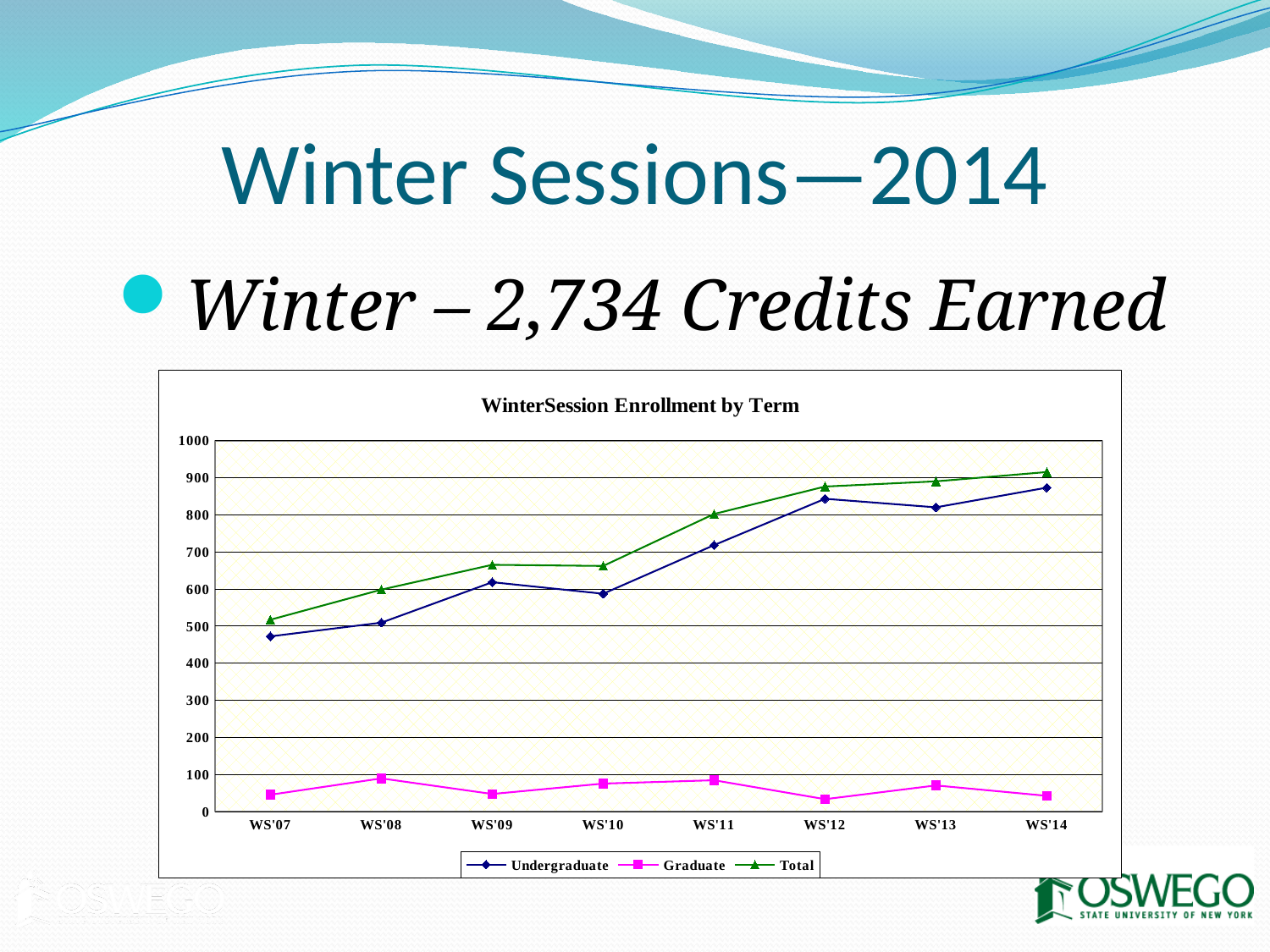
Which is larger, the Undergraduate value for WS'09 or for WS'10? WS'09 Which series is drawn with the pink line and square markers? Graduate Is the Undergraduate value for WS'07 greater or less than 500? less In which term is the Undergraduate enrollment lowest? WS'07 What kind of chart is shown on the slide? line chart Does the Total enrollment generally rise or fall from WS'07 to WS'14? rise What is the title of the chart? WinterSession Enrollment by Term In which term is the Total enrollment highest? WS'14 How many terms are plotted along the x axis of the chart? 8 Is the Total value for WS'12 greater or less than 800? greater In which term is the Total enrollment lowest? WS'07 How many series does the legend of the chart list? 3